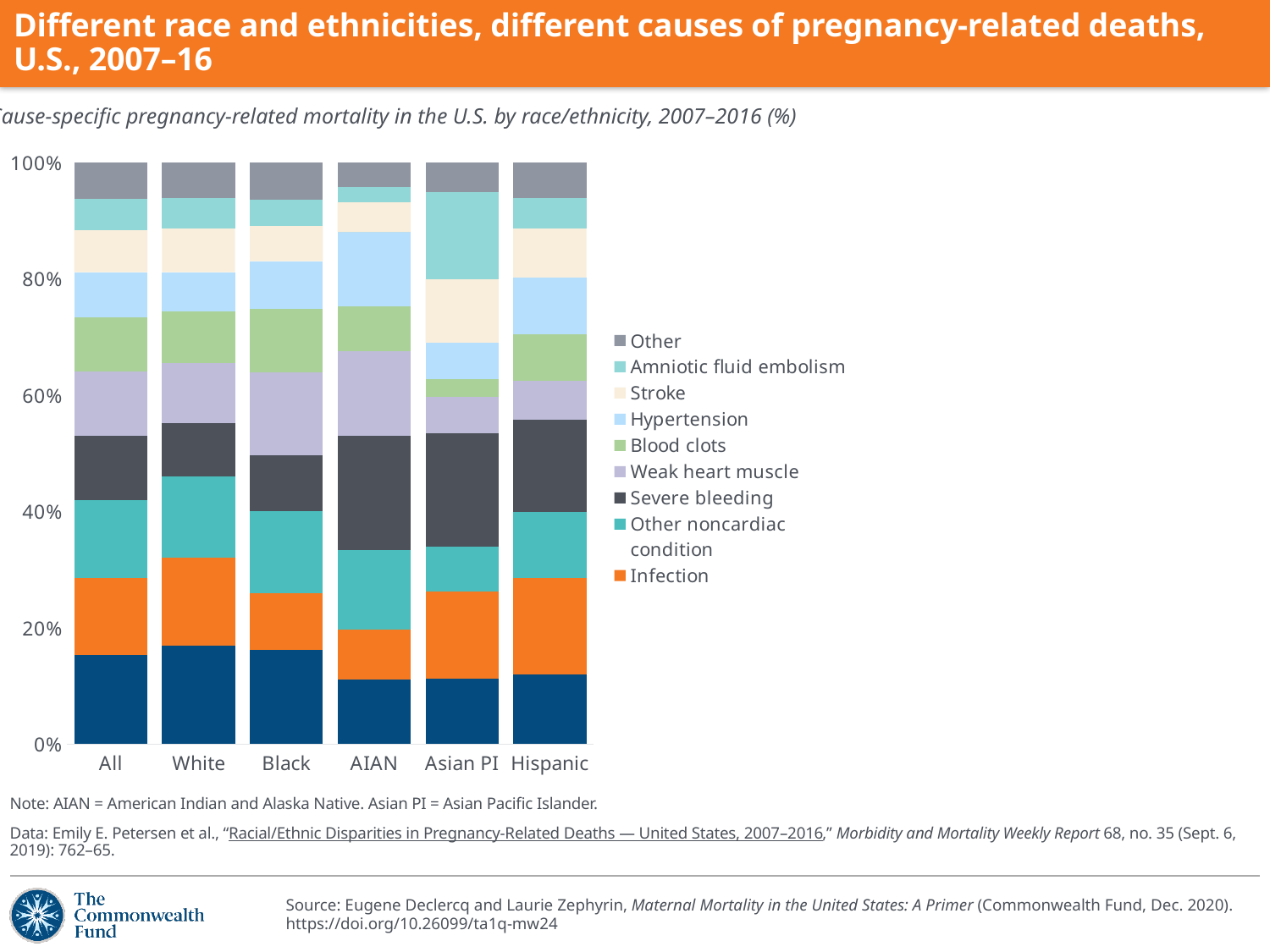
Which is larger, the Infection segment for White or for AIAN? White Which race/ethnicity group has the largest Amniotic fluid embolism segment? Asian PI What is the subtitle of the chart? Cause-specific pregnancy-related mortality in the U.S. by race/ethnicity, 2007–2016 (%) How many series does the legend list? 9 Is the Other noncardiac condition segment for White greater or less than 20%? less What kind of chart is shown on the slide? Stacked bar chart Is the Infection segment for the All bar greater or less than 20%? less Which is larger, the Amniotic fluid embolism segment for Asian PI or for All? Asian PI Is the Blood clots segment for Asian PI greater or less than 10%? less How many race/ethnicity categories are shown on the x axis? 6 Which race/ethnicity group has the largest Hypertension segment? AIAN